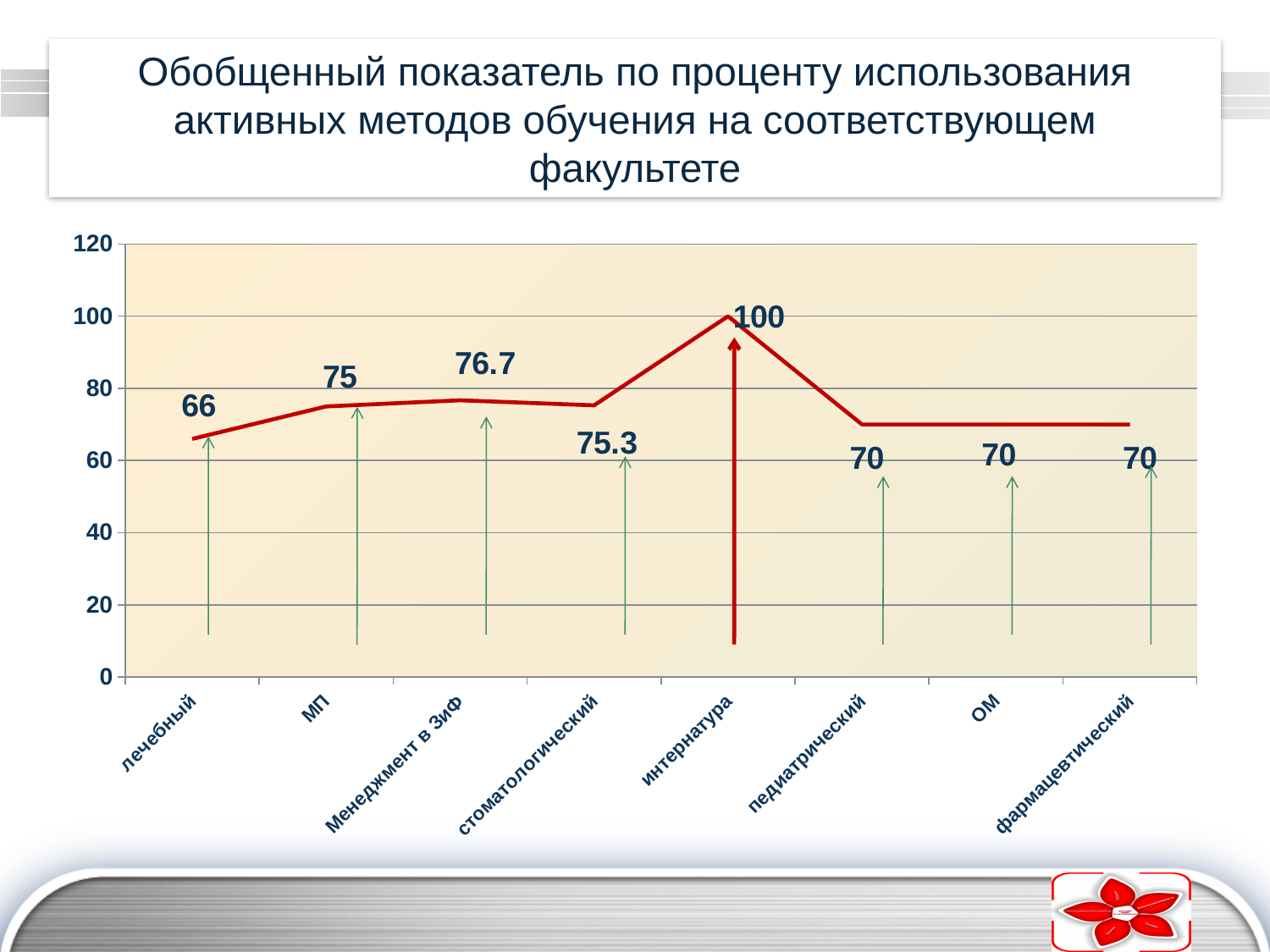
Is the value for ОМ greater or less than 80? less Which is larger, the value for МП or the value for лечебный? МП How many categories are plotted on the x axis? 8 What is the difference between the values for Менеджмент в ЗиФ and стоматологический? 1.4 What is the difference between the values for интернатура and педиатрический? 30 Which category has the highest value? интернатура What is the value for стоматологический? 75.3 What is the value for лечебный? 66 What is the value for интернатура? 100 What type of chart is shown on the slide? line chart Which category has the lowest value? лечебный What is the value for Менеджмент в ЗиФ? 76.7